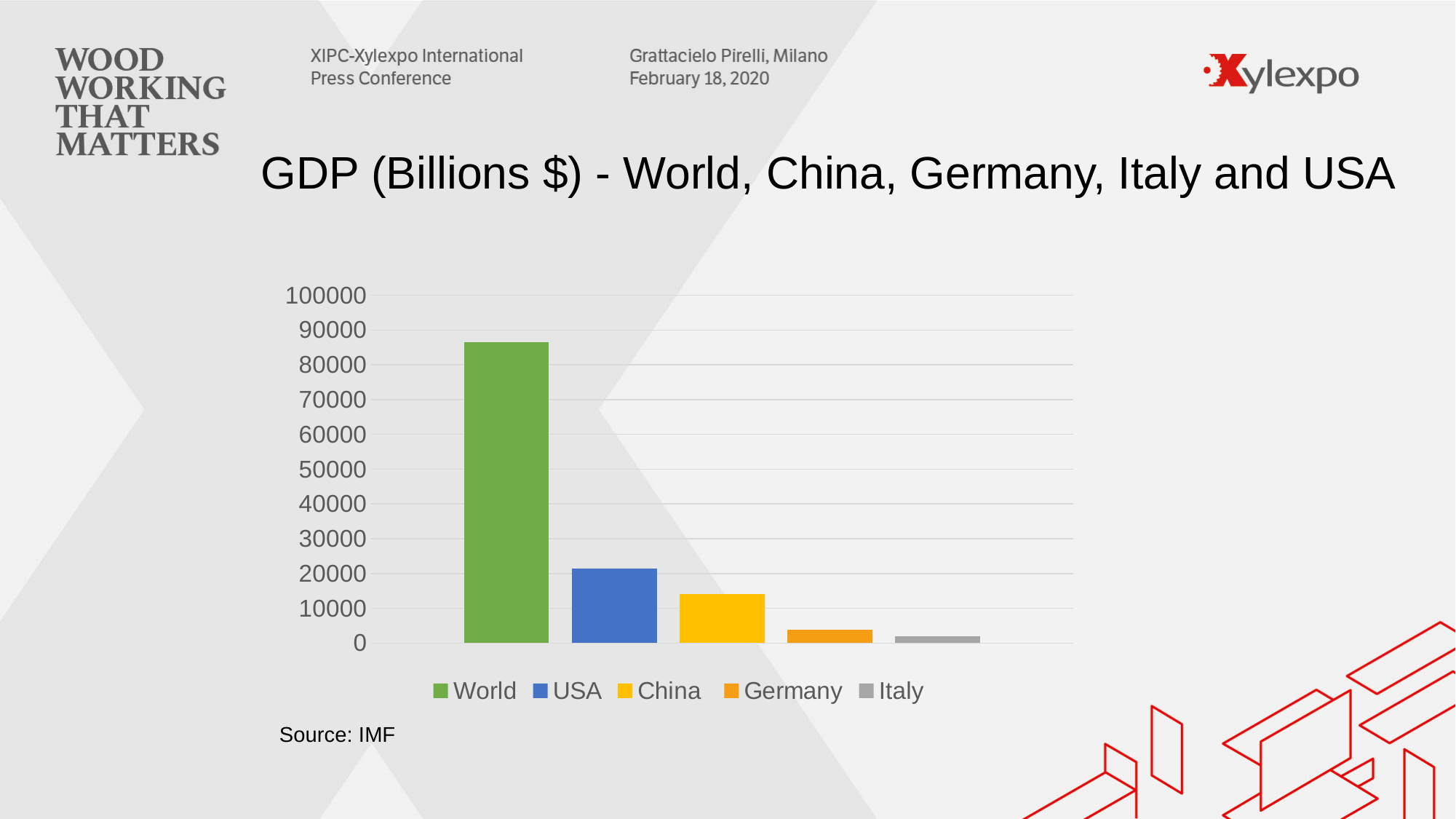
Is the value for USA greater or less than 30000? less Is the value for Germany greater or less than 10000? less Is the value for World greater or less than 80000? greater What source is cited for the chart data? IMF What is the title of the chart? GDP (Billions $) - World, China, Germany, Italy and USA Which series has the lowest GDP value in the chart? Italy Which series has the highest GDP value in the chart? World How many series does the legend list? 5 What kind of chart is shown on the slide? bar chart Which has a larger GDP value, USA or China? USA Which has a larger GDP value, Germany or Italy? Germany